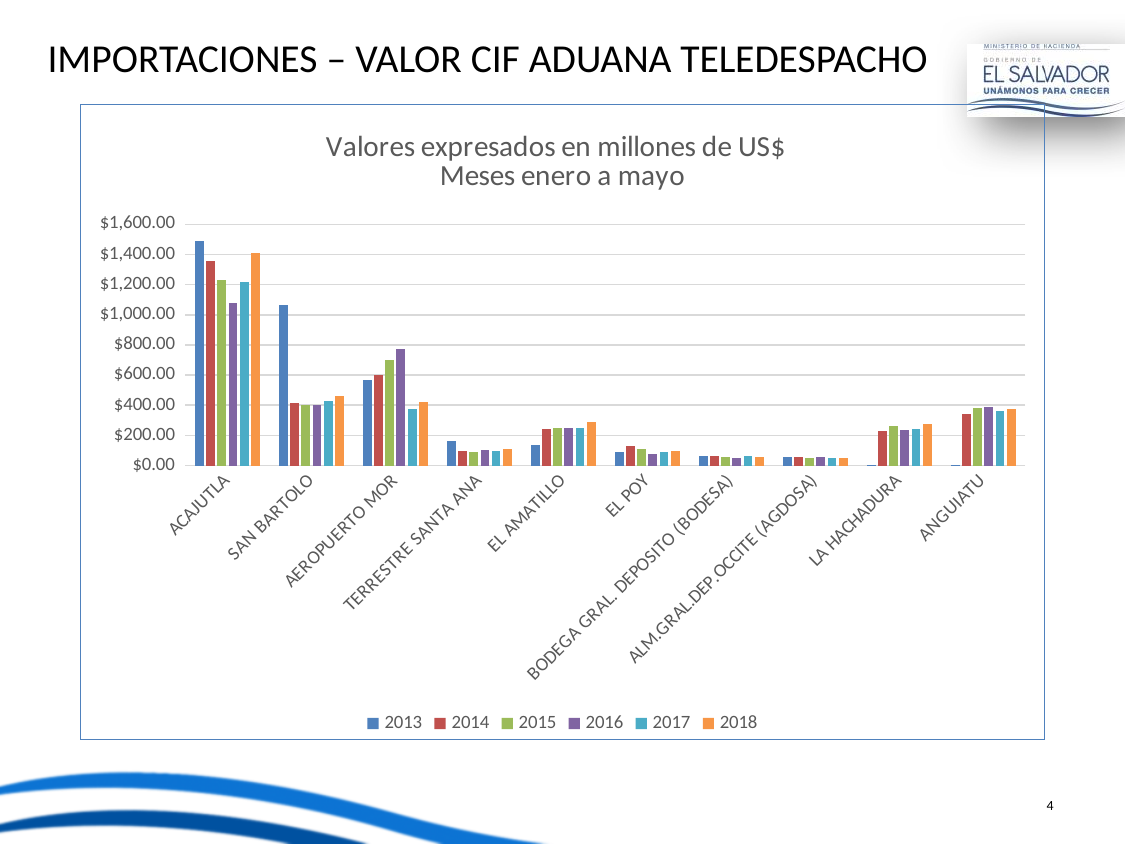
What unit does the chart subtitle say the values are expressed in? millones de US$ Which category has the highest value for 2013? ACAJUTLA What kind of chart is shown on the slide? bar chart How many customs offices (categories) are shown on the x axis? 10 For ACAJUTLA, do the values rise or fall from 2013 to 2016? fall Is the 2013 value for SAN BARTOLO greater or less than $1,000.00? greater For ACAJUTLA, which year has the highest value? 2013 Is the 2013 value for ACAJUTLA greater or less than $1,400.00? greater For SAN BARTOLO, which is larger, the 2013 value or the 2014 value? 2013 Is the 2013 value for EL POY greater or less than $200.00? less How many series does the legend list? 6